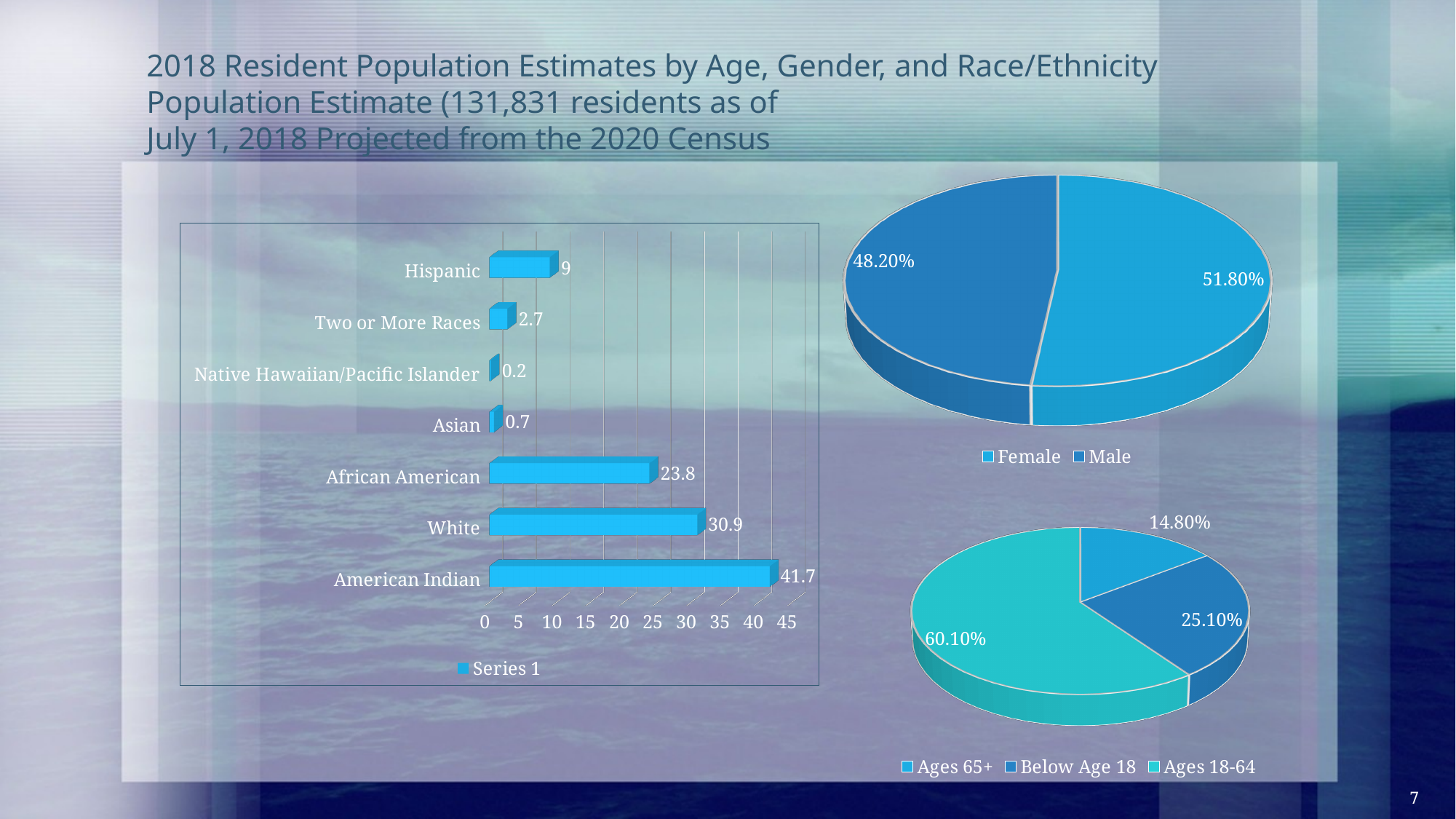
In the bar chart on the left, what is the difference between the values for American Indian and White? 10.8 How many entries does the legend of the bottom-right pie chart list? 3 In the bar chart on the left, which is larger, the value for Hispanic or the value for Two or More Races? Hispanic In the bar chart on the left, which category has the highest value? American Indian In the top-right pie chart, what share is Male? 48.20% In the bottom-right pie chart, what share is Ages 18-64? 60.10% What type of chart is the chart on the left of the slide? Bar chart In the top-right pie chart, what share is Female? 51.80% In the bar chart on the left, which category has the lowest value? Native Hawaiian/Pacific Islander How many categories are shown in the bar chart on the left? 7 In the bar chart on the left, what is the value for American Indian? 41.7 In the bar chart on the left, what is the value for African American? 23.8